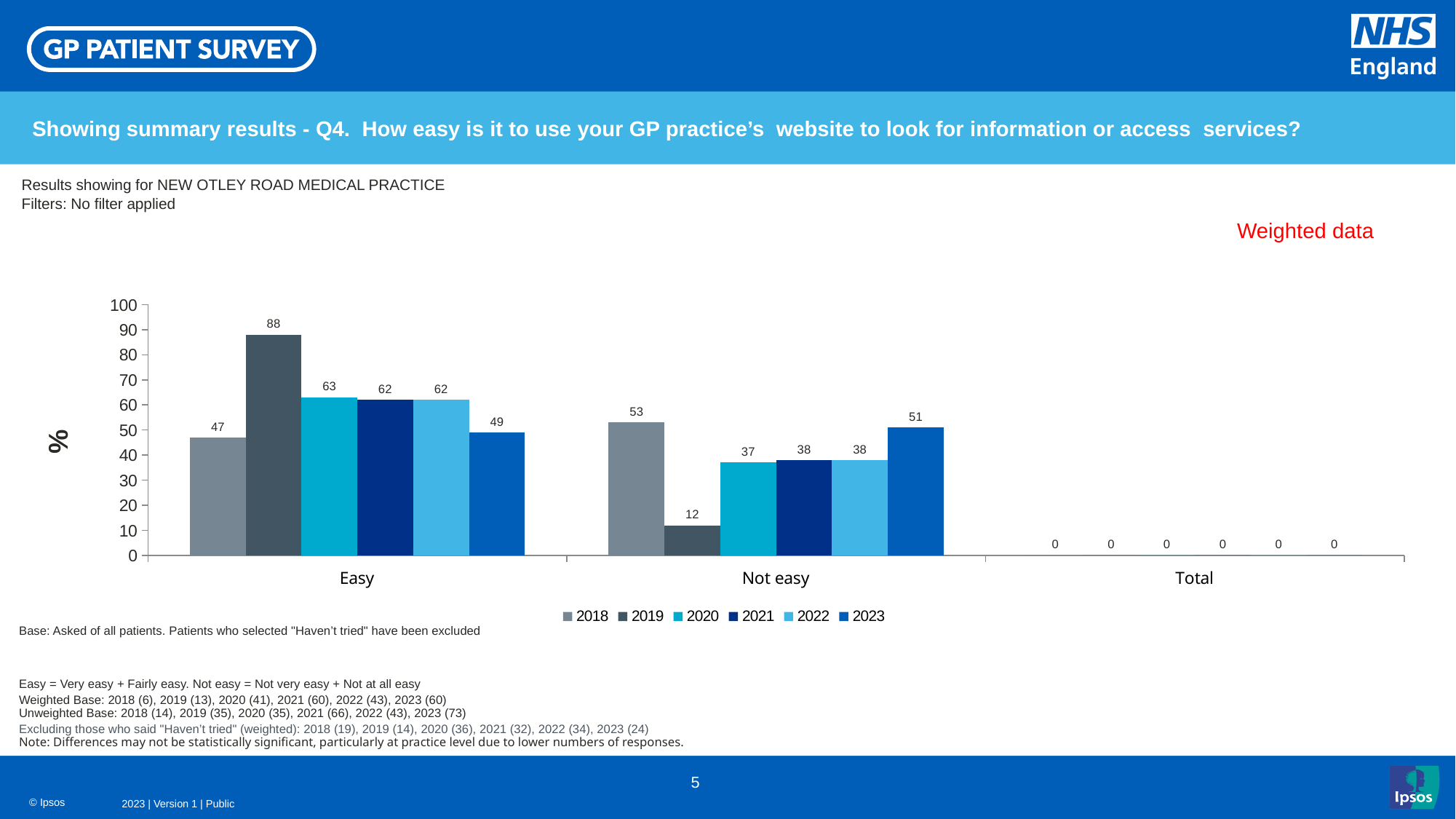
How many categories are shown on the x axis? 3 What is the value for 2023 in the Not easy category? 51 What is the label on the y axis? % What is the value for 2018 in the Easy category? 47 What kind of chart is shown on the slide? Bar chart What is the difference between the 2019 and 2018 values in the Easy category? 41 Which is larger: the 2018 value for Easy or the 2018 value for Not easy? Not easy Which year has the lowest value in the Not easy category? 2019 What is the value for 2019 in the Easy category? 88 Is the value for 2020 in the Easy category greater or less than 60? greater Which year has the highest value in the Easy category? 2019 How many series does the legend list? 6